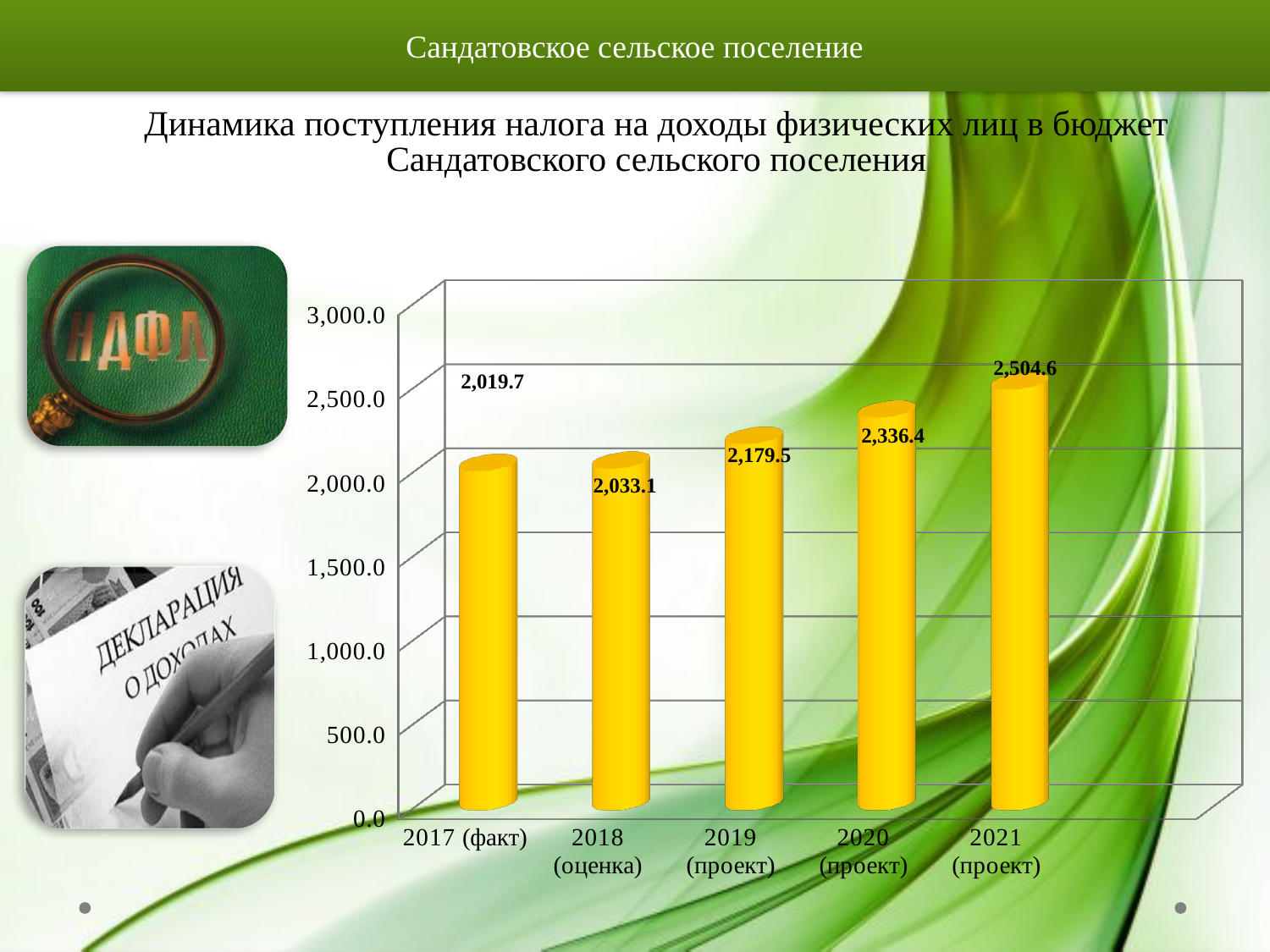
What is the value for 2017 (факт)? 2,019.7 What is the difference between the values for 2020 (проект) and 2019 (проект)? 156.9 Which year has the lowest value? 2017 (факт) What is the value for 2019 (проект)? 2,179.5 What is the difference between the values for 2021 (проект) and 2017 (факт)? 484.9 Which is larger, the value for 2020 (проект) or the value for 2018 (оценка)? 2020 (проект) How many years are shown on the x axis? 5 What kind of chart is shown on the slide? bar chart Do the values rise or fall from 2017 to 2021? rise Which year has the highest value? 2021 (проект) Is the value for 2021 (проект) greater or less than 2,500.0? greater What is the value for 2021 (проект)? 2,504.6